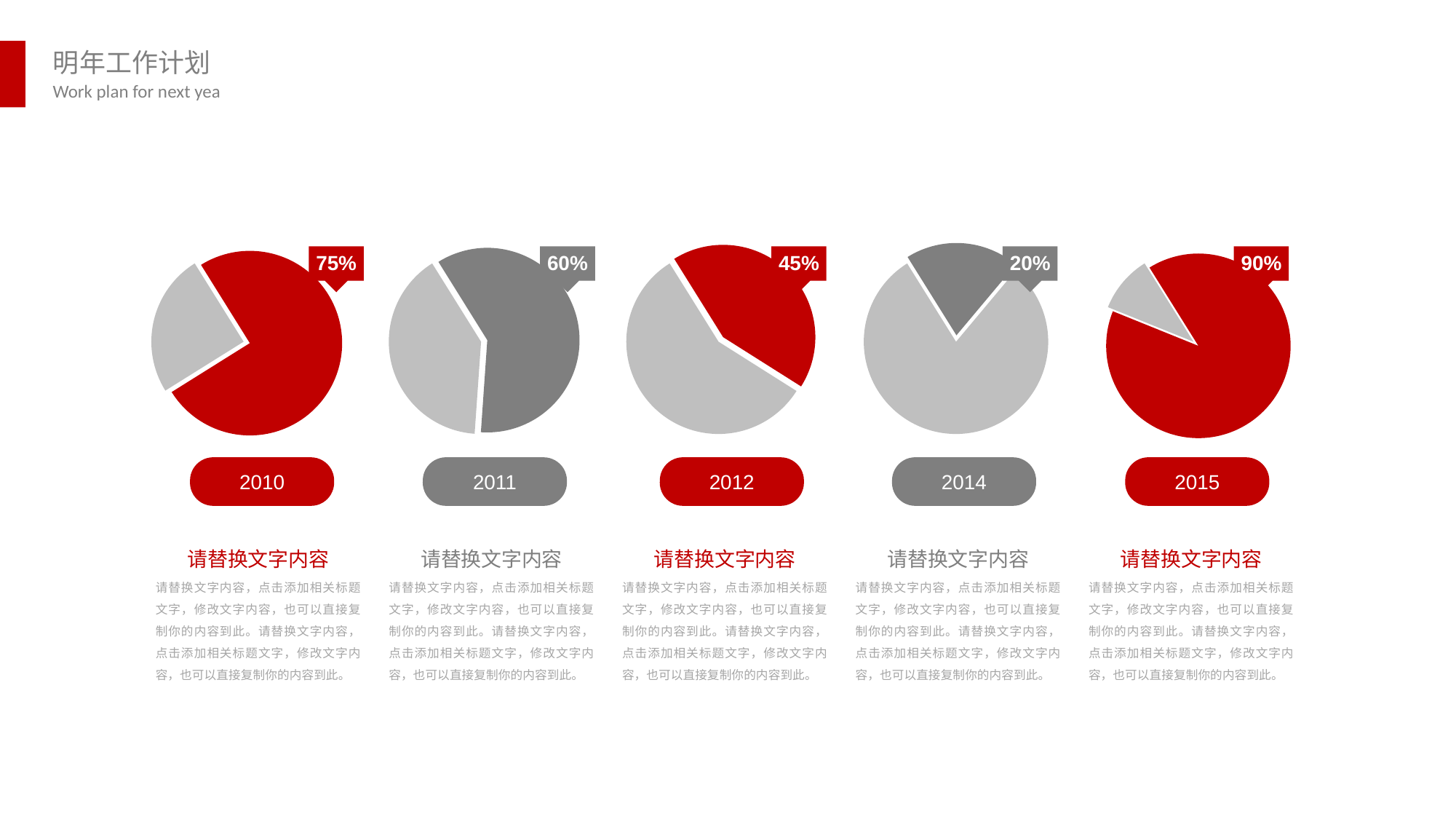
What percentage is shown on the pie chart labelled 2014? 20% What percentage is shown on the pie chart labelled 2015? 90% What percentage is shown on the pie chart labelled 2011? 60% What percentage is shown on the pie chart labelled 2012? 45% Which year's pie chart shows the highest percentage? 2015 What is the difference between the percentage on the 2015 pie chart and the percentage on the 2014 pie chart? 70% Which shows a larger percentage, the 2010 pie chart or the 2011 pie chart? 2010 What kind of chart is used for each year on the slide? Pie chart What colour is the highlighted slice on the pie chart labelled 2012? Red How many pie charts are on the slide? 5 Which year's pie chart shows the lowest percentage? 2014 What percentage is shown on the pie chart labelled 2010? 75%